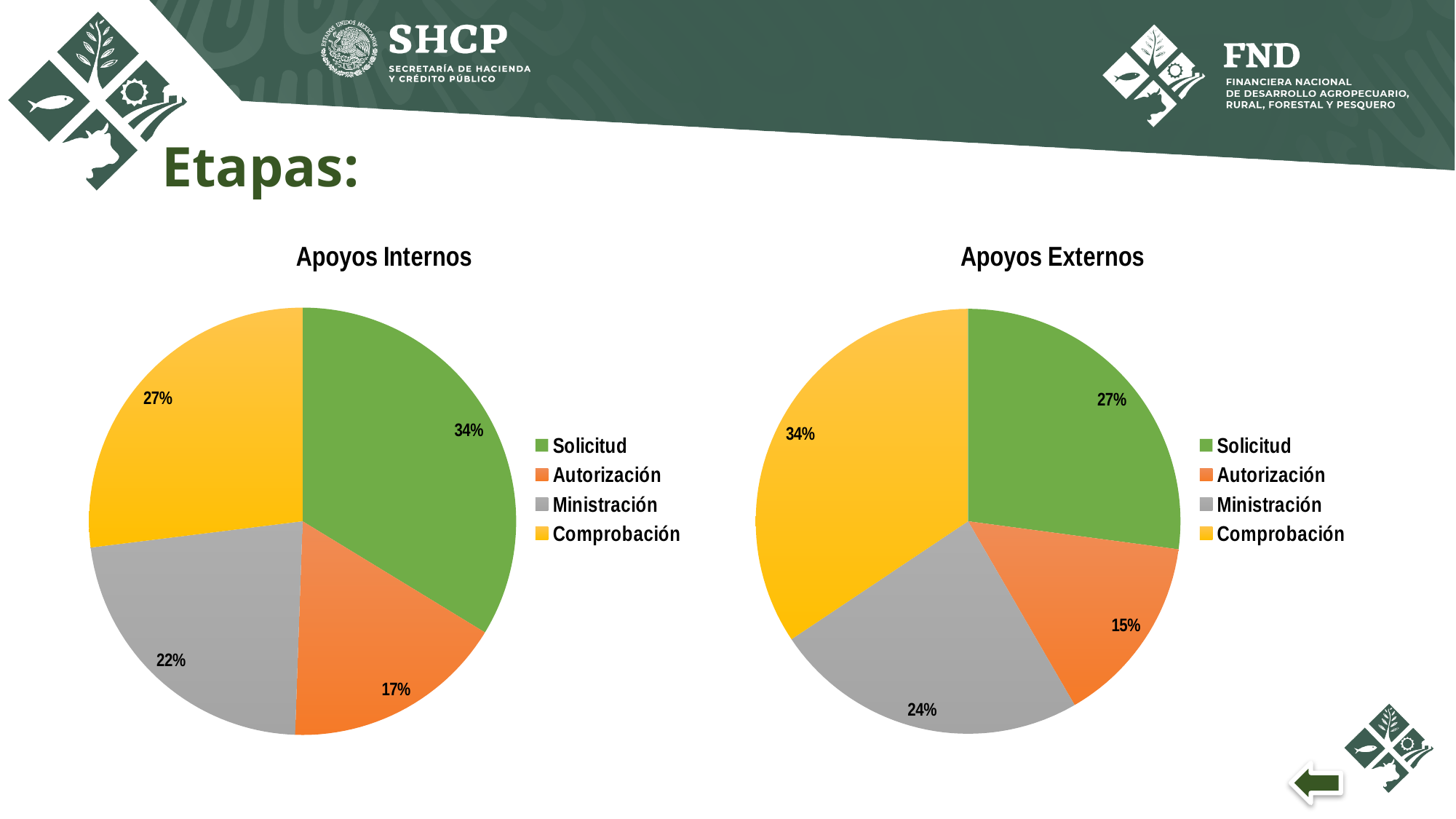
In the Apoyos Externos chart, what is the difference between the Comprobación and Autorización shares? 19% In the Apoyos Internos chart, what is the difference between the Solicitud and Autorización shares? 17% In the Apoyos Internos chart, which category has the largest slice? Solicitud In the Apoyos Internos chart, what share does Autorización have? 17% In the Apoyos Internos chart, what share does Solicitud have? 34% In the Apoyos Externos chart, what share does Comprobación have? 34% In the Apoyos Externos chart, what share does Ministración have? 24% In the Apoyos Externos chart, which is larger, Solicitud or Ministración? Solicitud What colour represents Ministración in the Apoyos Internos chart? Grey In the Apoyos Externos chart, which category has the smallest slice? Autorización What kind of chart is the Apoyos Externos chart? Pie chart How many categories does the legend of the Apoyos Internos chart list? 4